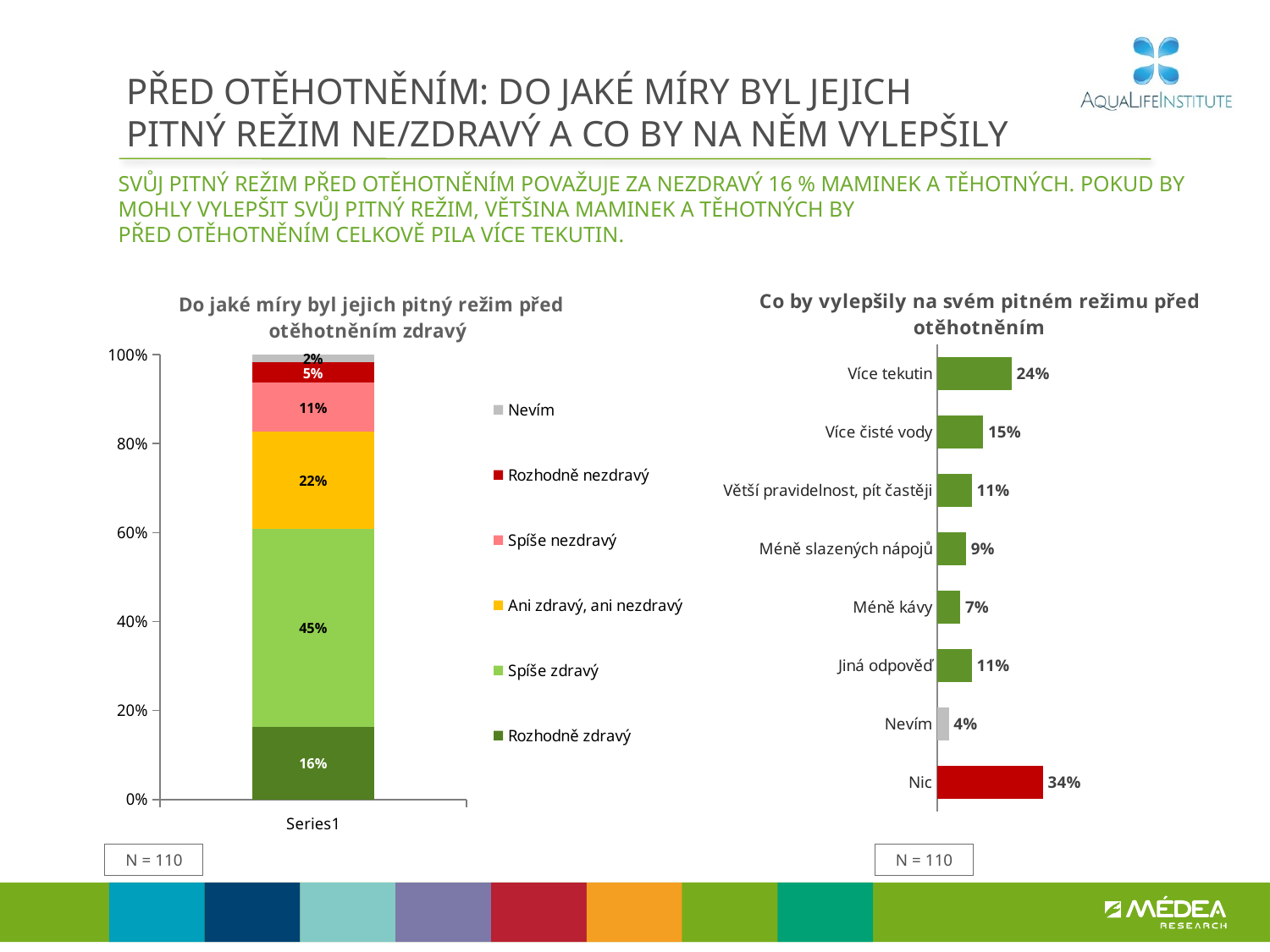
In the chart 'Co by vylepšily na svém pitném režimu před otěhotněním', which category has the highest value? Nic In the chart 'Co by vylepšily na svém pitném režimu před otěhotněním', what is the value for 'Méně kávy'? 7% In the chart 'Co by vylepšily na svém pitném režimu před otěhotněním', how many categories are shown? 8 In the chart 'Do jaké míry byl jejich pitný režim před otěhotněním zdravý', what is the value for 'Rozhodně nezdravý'? 5% In the chart 'Co by vylepšily na svém pitném režimu před otěhotněním', which category has the lowest value? Nevím In the chart 'Co by vylepšily na svém pitném režimu před otěhotněním', which is larger: 'Více čisté vody' or 'Méně slazených nápojů'? Více čisté vody In the chart 'Do jaké míry byl jejich pitný režim před otěhotněním zdravý', which category has the largest share? Spíše zdravý In the chart 'Do jaké míry byl jejich pitný režim před otěhotněním zdravý', how many entries does the legend list? 6 In the chart 'Co by vylepšily na svém pitném režimu před otěhotněním', what is the value for 'Více tekutin'? 24% In the chart 'Do jaké míry byl jejich pitný režim před otěhotněním zdravý', what is the difference between 'Ani zdravý, ani nezdravý' and 'Rozhodně zdravý'? 6% In the chart 'Do jaké míry byl jejich pitný režim před otěhotněním zdravý', which category has the smallest share? Nevím In the chart 'Do jaké míry byl jejich pitný režim před otěhotněním zdravý', what is the value for 'Spíše zdravý'? 45%